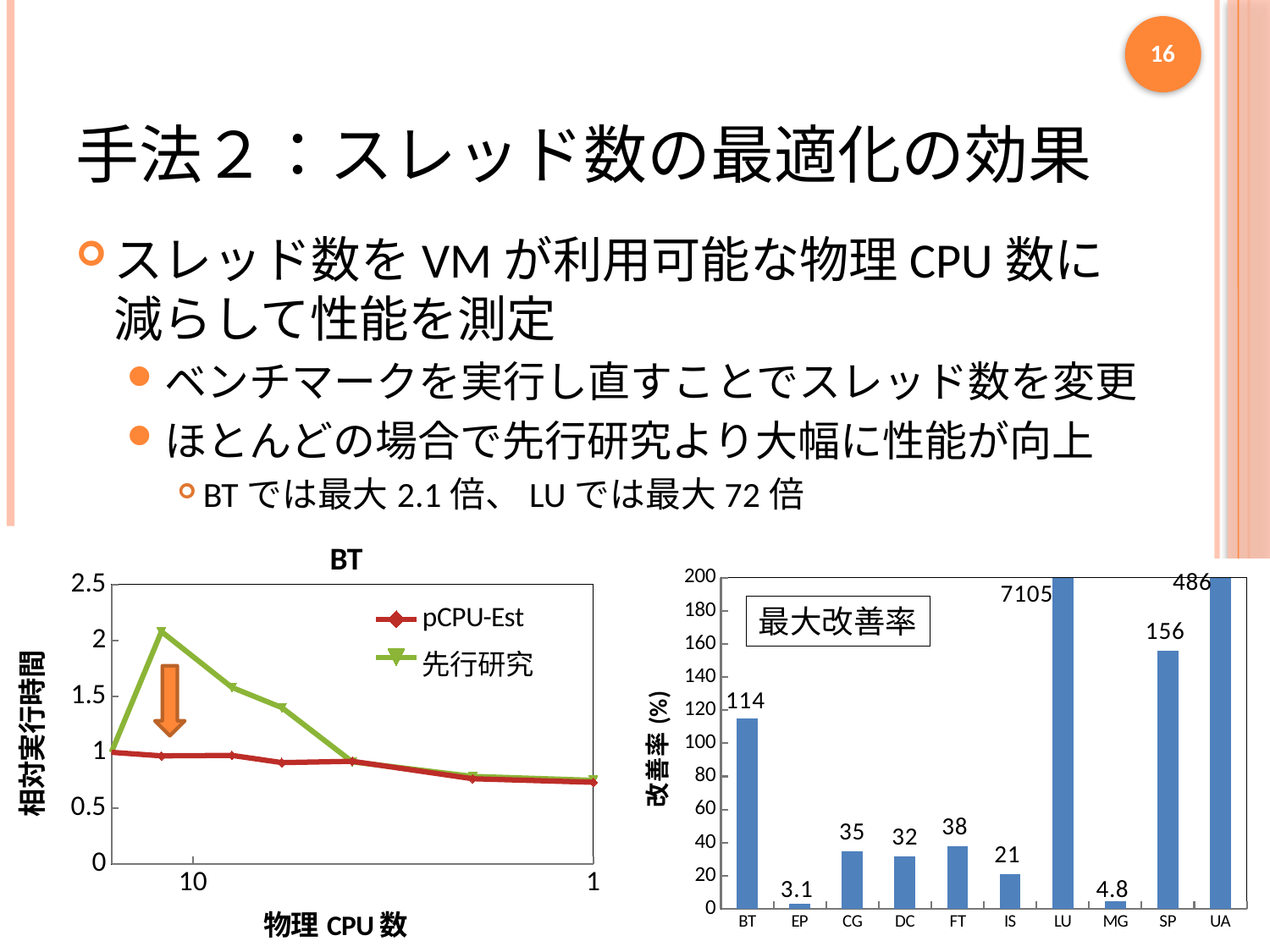
In the 最大改善率 bar chart, what is the difference between the values for SP and BT? 42 How many categories are shown in the 最大改善率 bar chart? 10 In the 最大改善率 bar chart, what is the value for MG? 4.8 In the 最大改善率 bar chart, what is the value for BT? 114 In the 最大改善率 bar chart, which category has the highest value? LU What kind of chart is the BT chart on the left? line chart In the 最大改善率 bar chart, which category has the lowest value? EP In the BT chart, is the peak value of the 先行研究 series greater or less than 2? greater In the 最大改善率 bar chart, what is the value for LU? 7105 How many series does the legend of the BT chart list? 2 What kind of chart is the 最大改善率 chart? bar chart In the 最大改善率 bar chart, which is larger, the value for CG or the value for FT? FT